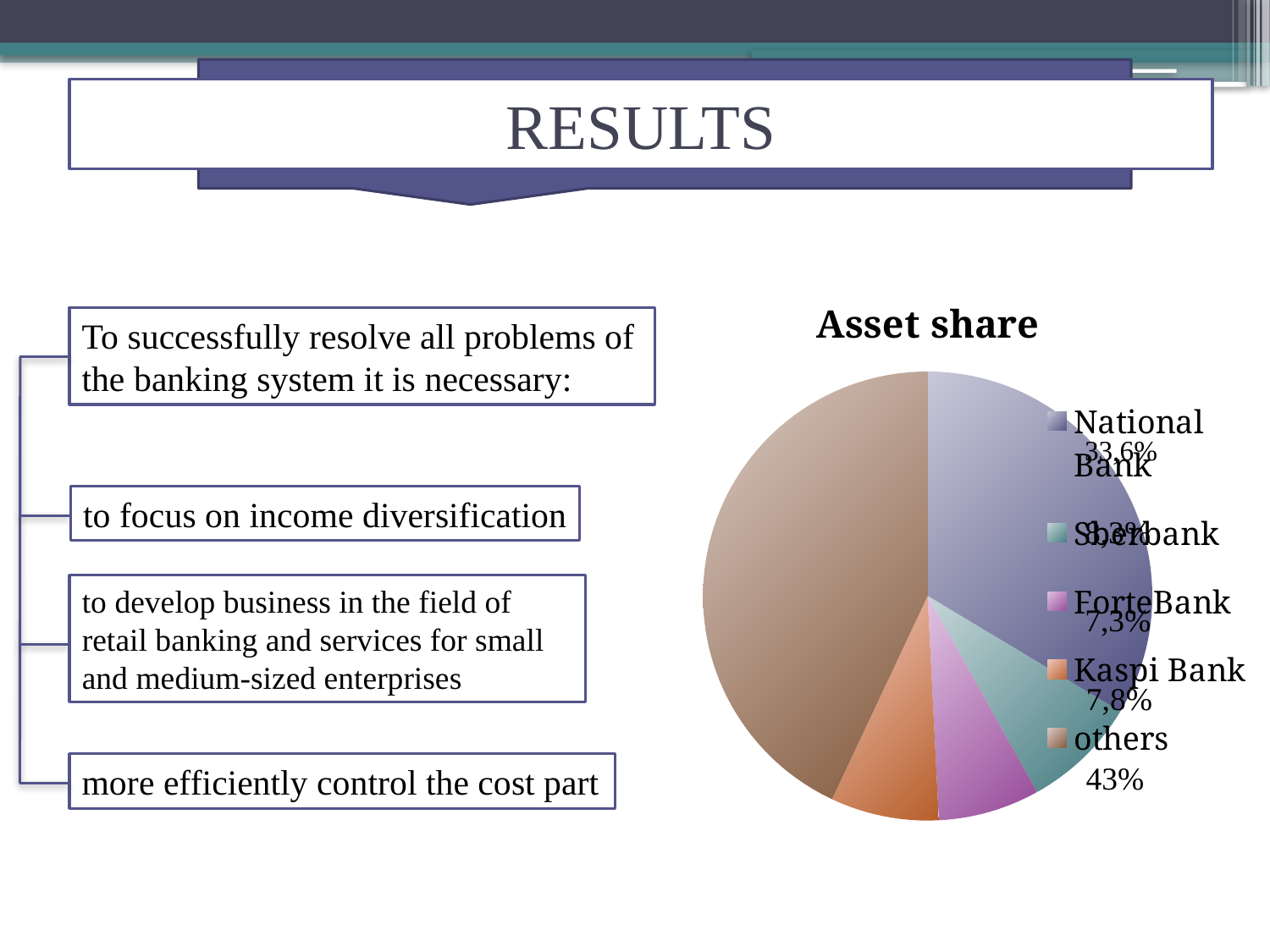
What is the title of the chart? Asset share What is the asset share of Kaspi Bank? 7,8% Which named bank has the smallest asset share? ForteBank What is the asset share of National Bank? 33,6% What kind of chart is shown on the slide? pie chart What is the asset share of ForteBank? 7,3% What is the difference between the asset share of 'others' and that of National Bank? 9,4% Which is larger, the asset share of National Bank or of 'others'? others Which category has the largest slice of the pie? others Which is larger, the asset share of Kaspi Bank or of ForteBank? Kaspi Bank What share of assets does the 'others' slice represent? 43% How many categories does the legend of the pie chart list? 5